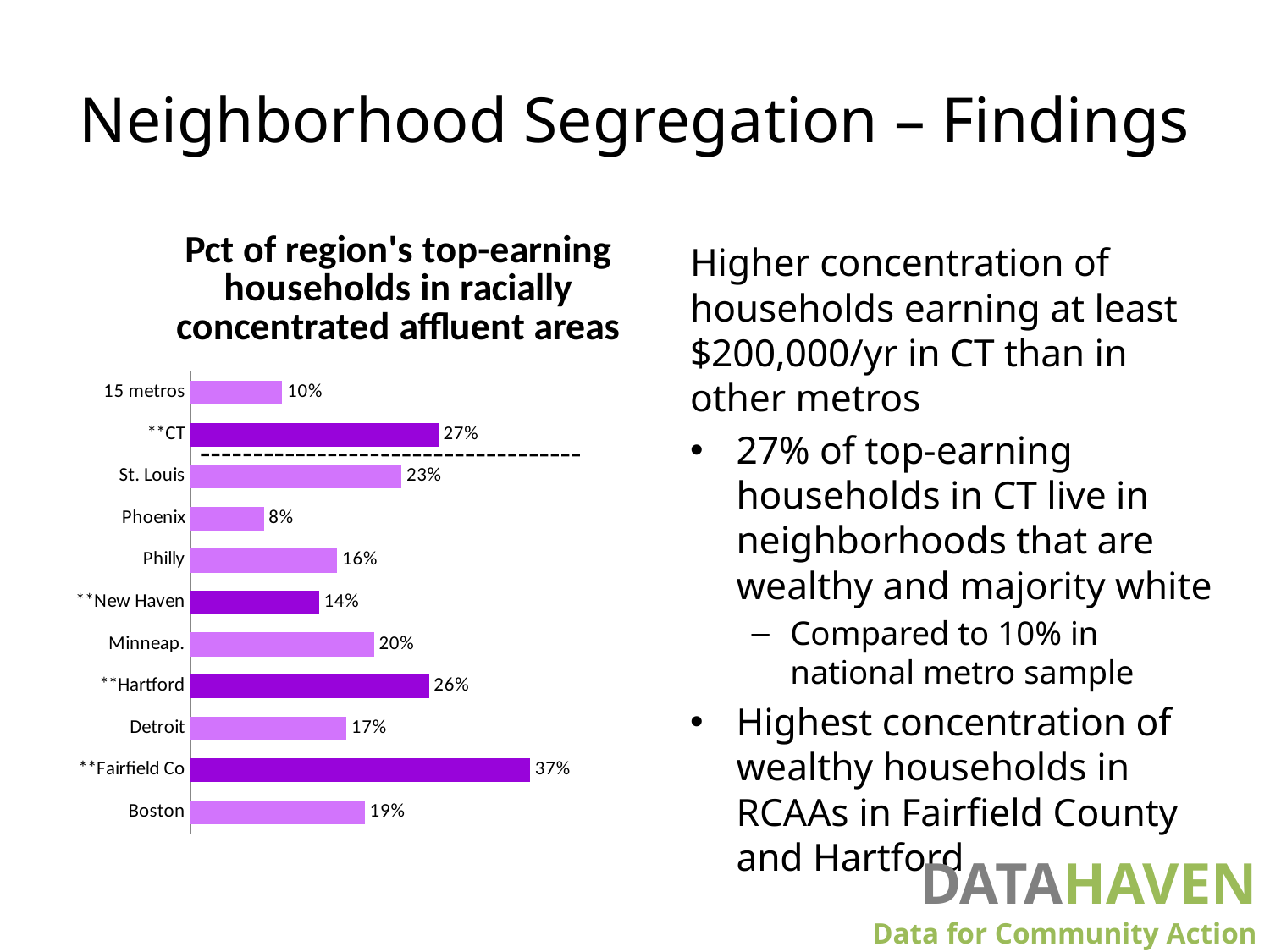
What is the value for St. Louis? 23% Which has a larger value, Minneap. or Detroit? Minneap. What is the difference between the values for **CT and 15 metros? 17% What is the value for **New Haven? 14% What is the difference between the values for **Fairfield Co and **Hartford? 11% Which category has the highest value? **Fairfield Co What is the value for 15 metros? 10% How many categories are shown in the chart? 11 What kind of chart is shown on the slide? Bar chart What is the value for **Fairfield Co? 37% Which category has the lowest value? Phoenix What is the title of the chart? Pct of region's top-earning households in racially concentrated affluent areas